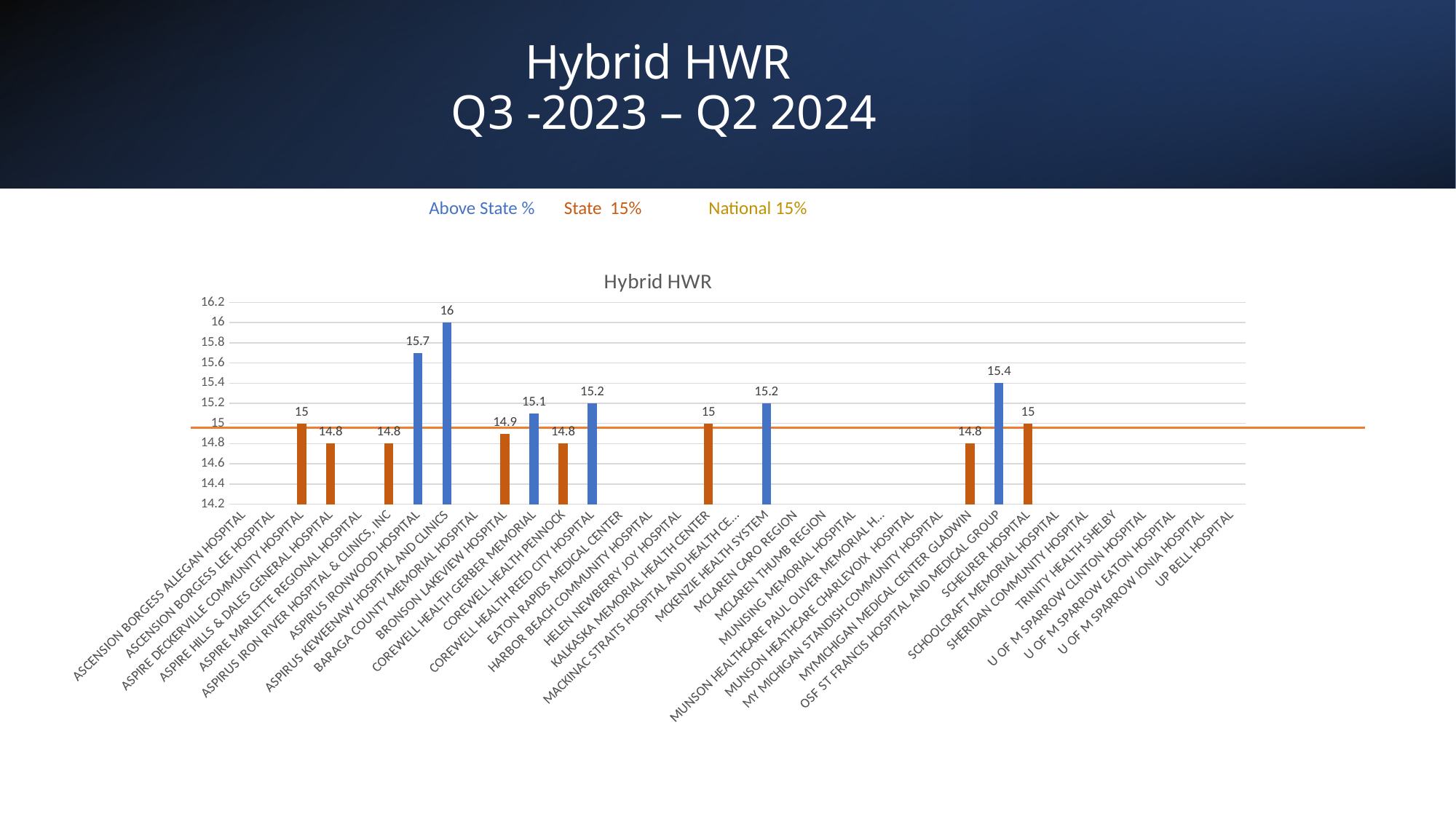
What is the value for ASPIRUS IRONWOOD HOSPITAL? 15.7 What is the value for ASPIRUS KEWEENAW HOSPITAL AND CLINICS? 16 Is the value for ASPIRUS IRONWOOD HOSPITAL greater or less than 15.4? greater What is the value for OSF ST FRANCIS HOSPITAL AND MEDICAL GROUP? 15.4 What is the title of the chart? Hybrid HWR What is the difference between the values for ASPIRUS KEWEENAW HOSPITAL AND CLINICS and ASPIRUS IRONWOOD HOSPITAL? 0.3 What is the difference between the values for OSF ST FRANCIS HOSPITAL AND MEDICAL GROUP and MYMICHIGAN MEDICAL CENTER GLADWIN? 0.6 Which is larger, the value for COREWELL HEALTH REED CITY HOSPITAL or the value for COREWELL HEALTH PENNOCK? COREWELL HEALTH REED CITY HOSPITAL What type of chart is shown on the slide? bar chart What is the value for BRONSON LAKEVIEW HOSPITAL? 14.9 Which hospital has the highest value on the chart? ASPIRUS KEWEENAW HOSPITAL AND CLINICS What is the value for COREWELL HEALTH GERBER MEMORIAL? 15.1